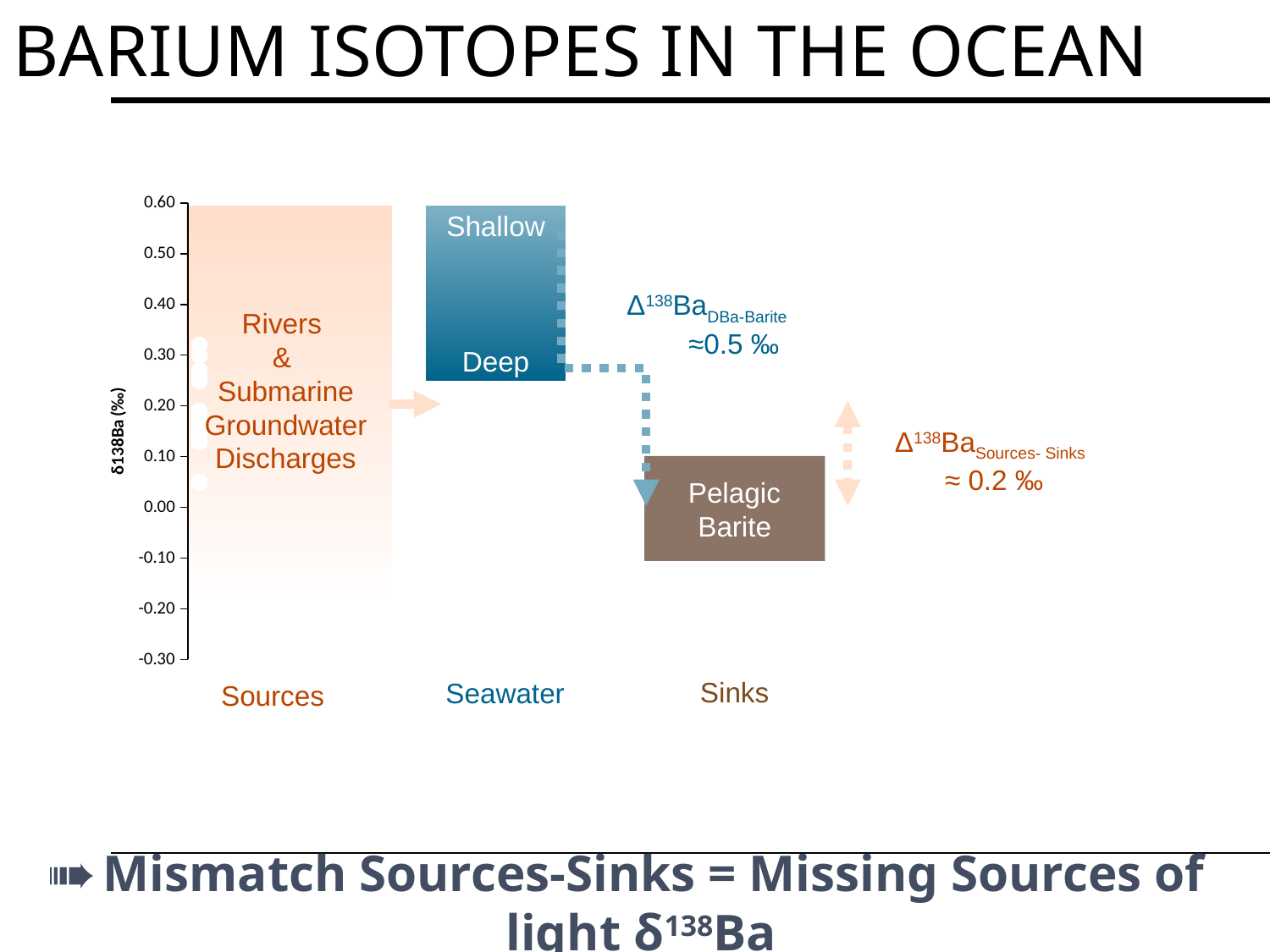
What is the label on the y axis of the chart? δ138Ba (‰) What value does the chart give for Δ138Ba Sources-Sinks? ≈ 0.2 ‰ How many categories are labelled along the x axis of the chart? 3 Is the top of the Pelagic Barite box greater or less than 0.30 on the δ138Ba axis? less Is the bottom of the Pelagic Barite box greater or less than 0.00 on the δ138Ba axis? less What is the highest tick value shown on the y axis? 0.60 Is the top of the Seawater box greater or less than 0.50 on the δ138Ba axis? greater What two labels appear inside the Seawater box? Shallow and Deep Which is larger, Δ138Ba DBa-Barite or Δ138Ba Sources-Sinks? Δ138Ba DBa-Barite Which sits higher on the δ138Ba axis, the Seawater box or the Pelagic Barite box? Seawater What is the lowest tick value shown on the y axis? -0.30 What value does the chart give for Δ138Ba DBa-Barite? ≈0.5 ‰